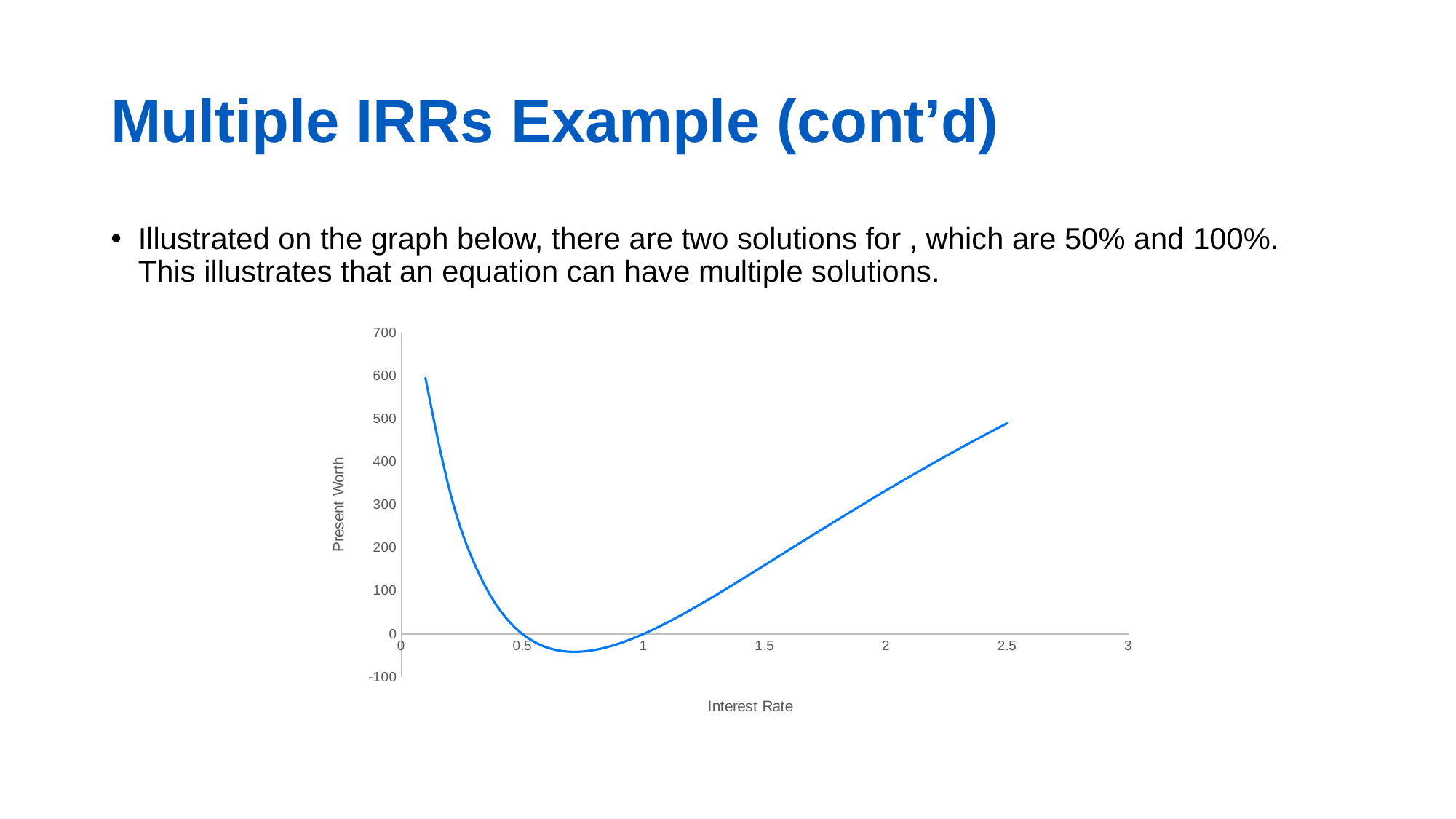
Which is larger: the Present Worth at the left end of the curve (near Interest Rate 0) or at the right end (Interest Rate 2.5)? the left end (near 0) What is the label of the horizontal axis of the chart? Interest Rate Is the Present Worth at an Interest Rate of 2 greater or less than 300? greater What kind of chart is shown on the slide? line chart Is the lowest point of the curve above or below a Present Worth of 0? below What is the label of the vertical axis of the chart? Present Worth Is the Present Worth at an Interest Rate of 1.5 greater or less than 100? greater Does the Present Worth rise or fall as the Interest Rate increases from 0 to 0.5? falls Which is larger: the Present Worth at an Interest Rate of 2 or at an Interest Rate of 1.5? at 2 Does the Present Worth rise or fall as the Interest Rate increases from 1 to 2.5? rises Is the Present Worth at an Interest Rate of 0.75 greater or less than 0? less